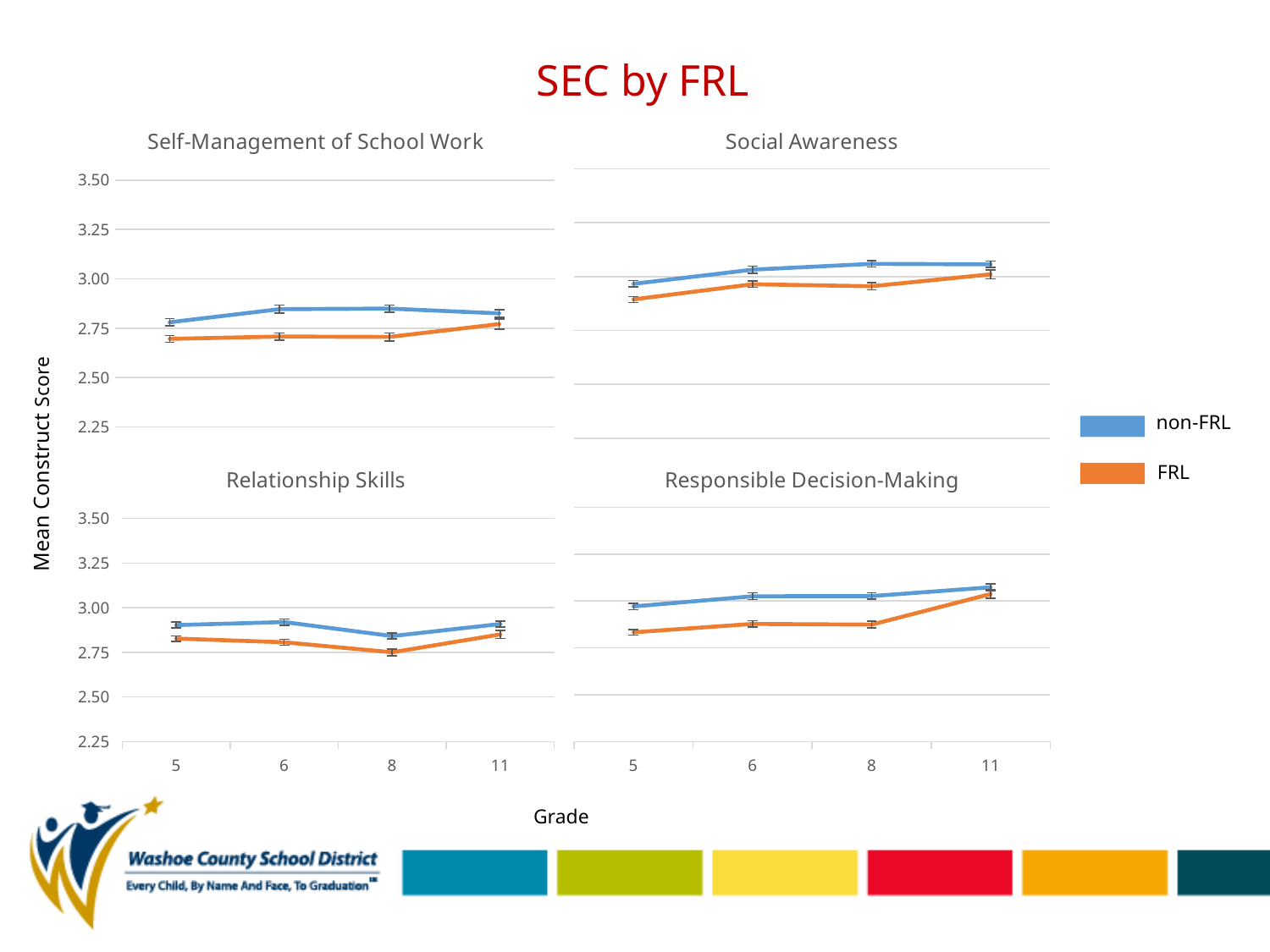
In the Responsible Decision-Making chart, is the FRL value at grade 5 greater or less than 3.00? less In the Relationship Skills chart, is the FRL value at grade 8 greater or less than 3.00? less What kind of chart is the Self-Management of School Work chart? line chart In the Responsible Decision-Making chart, does the non-FRL series generally rise or fall from grade 5 to grade 11? rise In the Self-Management of School Work chart, which series has the larger value at grade 6, non-FRL or FRL? non-FRL How many series does the legend list? 2 In the Responsible Decision-Making chart, which series has the larger value at grade 5, non-FRL or FRL? non-FRL In the Responsible Decision-Making chart, at which grade is the FRL series highest? 11 In the Social Awareness chart, is the non-FRL value at grade 8 greater or less than 3.00? greater How many grade levels are plotted on the x axis of the Relationship Skills chart? 4 In the Relationship Skills chart, at which grade is the FRL series lowest? 8